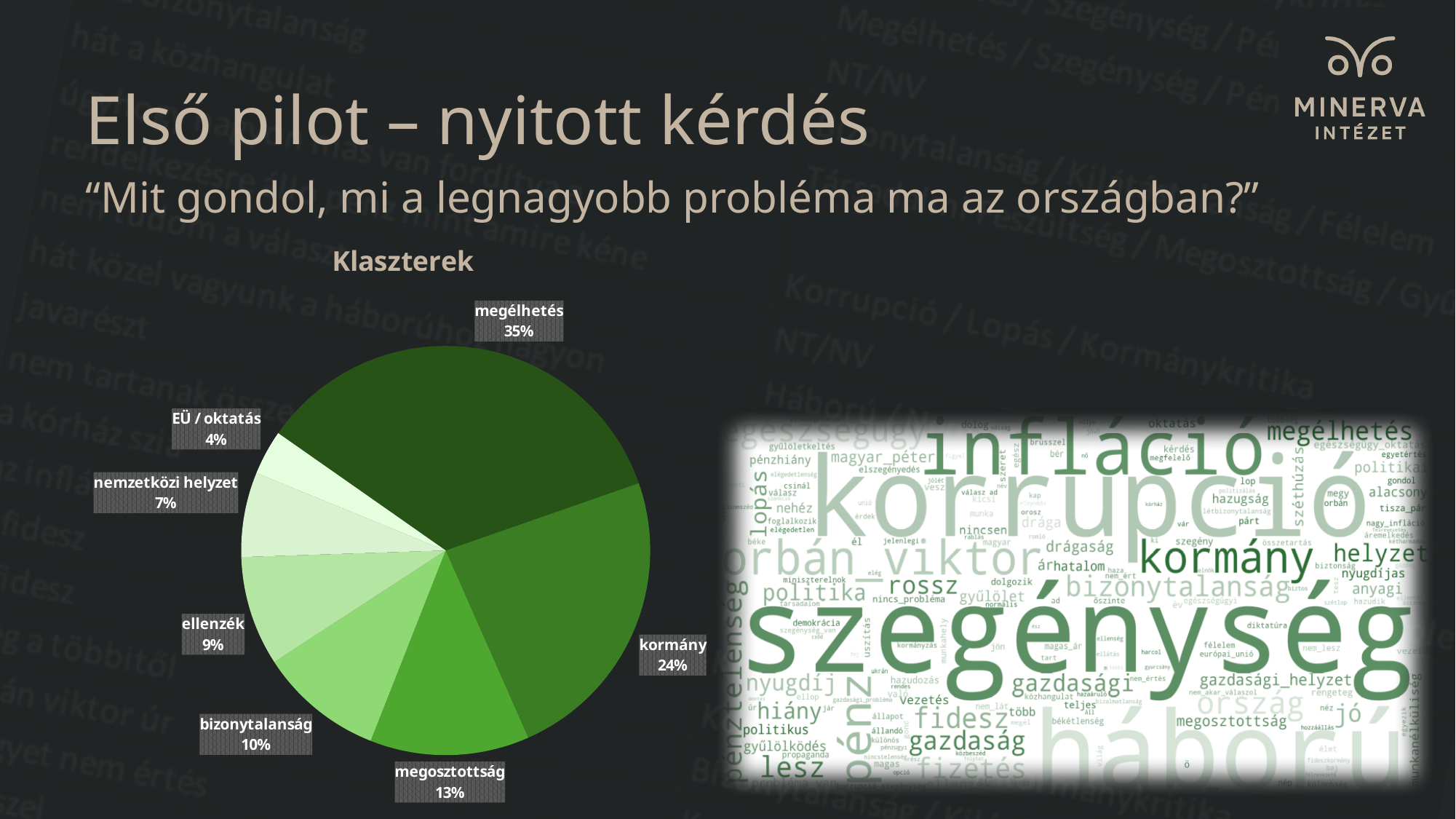
What is the title of the pie chart? Klaszterek How many categories are shown in the pie chart? 7 What kind of chart is shown under the title "Klaszterek"? pie chart What is the value shown for "kormány" in the pie chart? 24% What is the difference in percentage points between "megélhetés" and "kormány"? 11 What share of the pie chart does "megélhetés" have? 35% What is the value for "EÜ / oktatás" in the pie chart? 4% Which category has the smallest slice in the pie chart? EÜ / oktatás Which category has the largest slice in the pie chart? megélhetés What is the difference between "nemzetközi helyzet" and "EÜ / oktatás" in percentage points? 3 Which is larger in the pie chart, "bizonytalanság" or "ellenzék"? bizonytalanság What percentage is shown for "megosztottság"? 13%